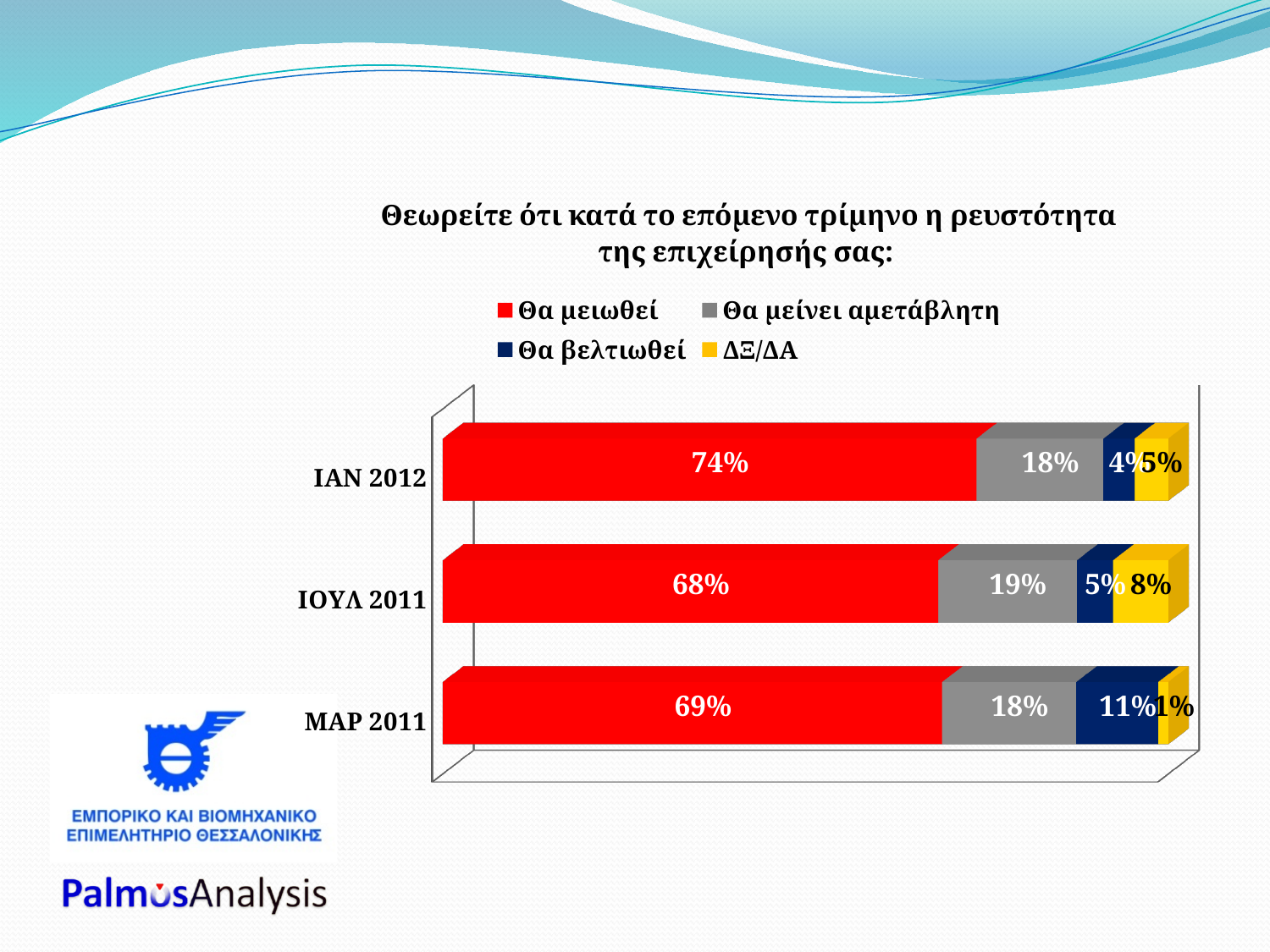
What is the difference between the "Θα μειωθεί" values for ΙΑΝ 2012 and ΙΟΥΛ 2011? 6% Which colour represents "Θα μείνει αμετάβλητη" in the chart? Gray What is the value for "ΔΞ/ΔΑ" in ΙΟΥΛ 2011? 8% What is the value for "Θα μείνει αμετάβλητη" in ΙΟΥΛ 2011? 19% What kind of chart is shown on the slide? Stacked bar chart How many series does the legend list? 4 What is the value for "Θα βελτιωθεί" in ΜΑΡ 2011? 11% How many periods (categories) are shown on the chart? 3 Which period has the lowest value for "ΔΞ/ΔΑ"? ΜΑΡ 2011 Which is larger: the "Θα βελτιωθεί" value for ΜΑΡ 2011 or for ΙΑΝ 2012? ΜΑΡ 2011 What percentage of respondents in ΙΑΝ 2012 answered "Θα μειωθεί"? 74% Which period has the highest value for "Θα μειωθεί"? ΙΑΝ 2012